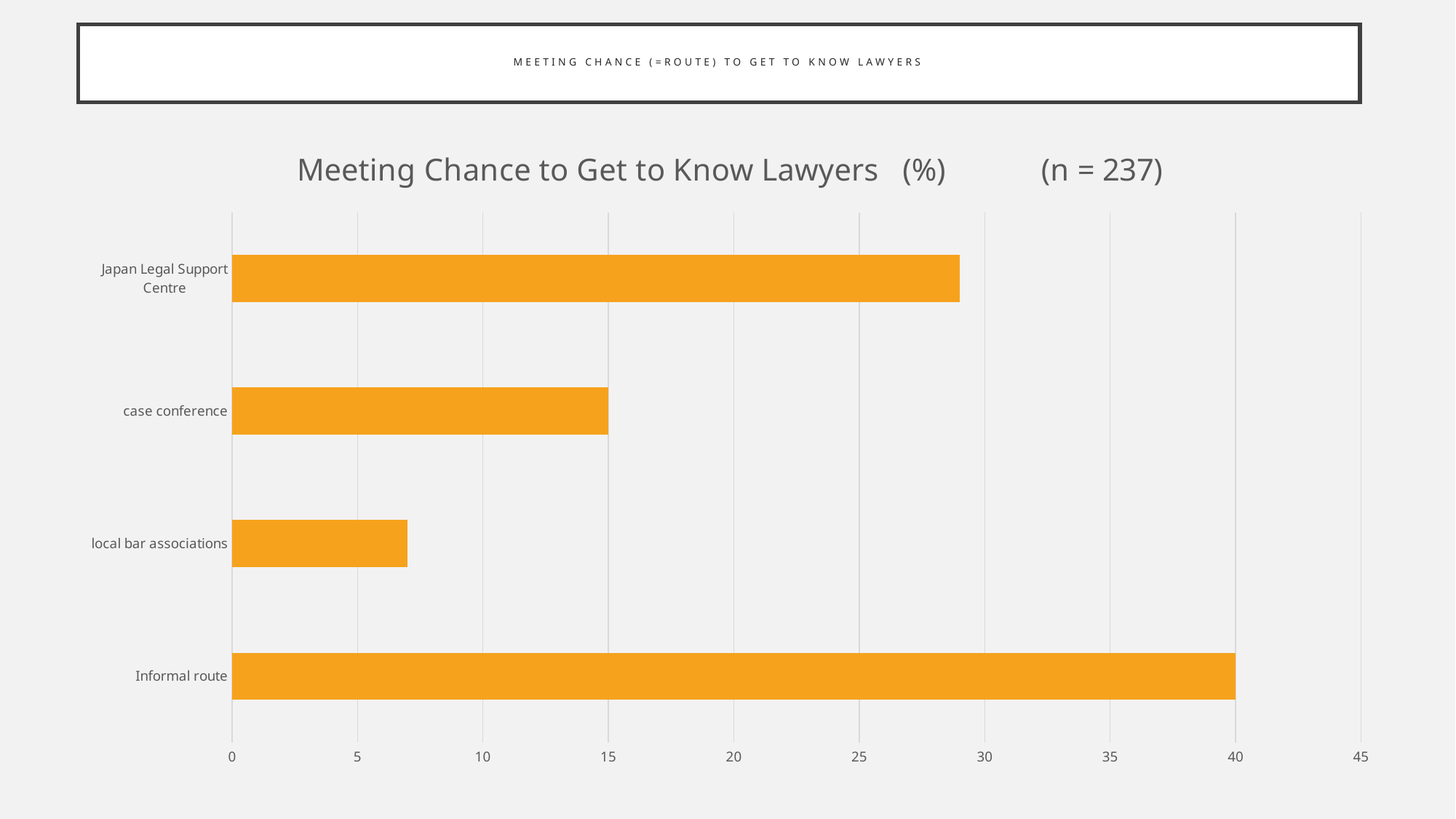
What is the value for Informal route? 40 What is the title of the chart? Meeting Chance to Get to Know Lawyers (%) (n = 237) Is the value for Japan Legal Support Centre greater or less than 25? greater What is the value for case conference? 15 Which category has the highest value? Informal route What is the difference between the values for Informal route and case conference? 25 What kind of chart is shown on the slide? bar chart Is the value for local bar associations greater or less than 10? less How many categories are plotted in the chart? 4 Which is larger, the value for Japan Legal Support Centre or the value for case conference? Japan Legal Support Centre Which category has the lowest value? local bar associations What sample size (n) is stated in the chart title? n = 237